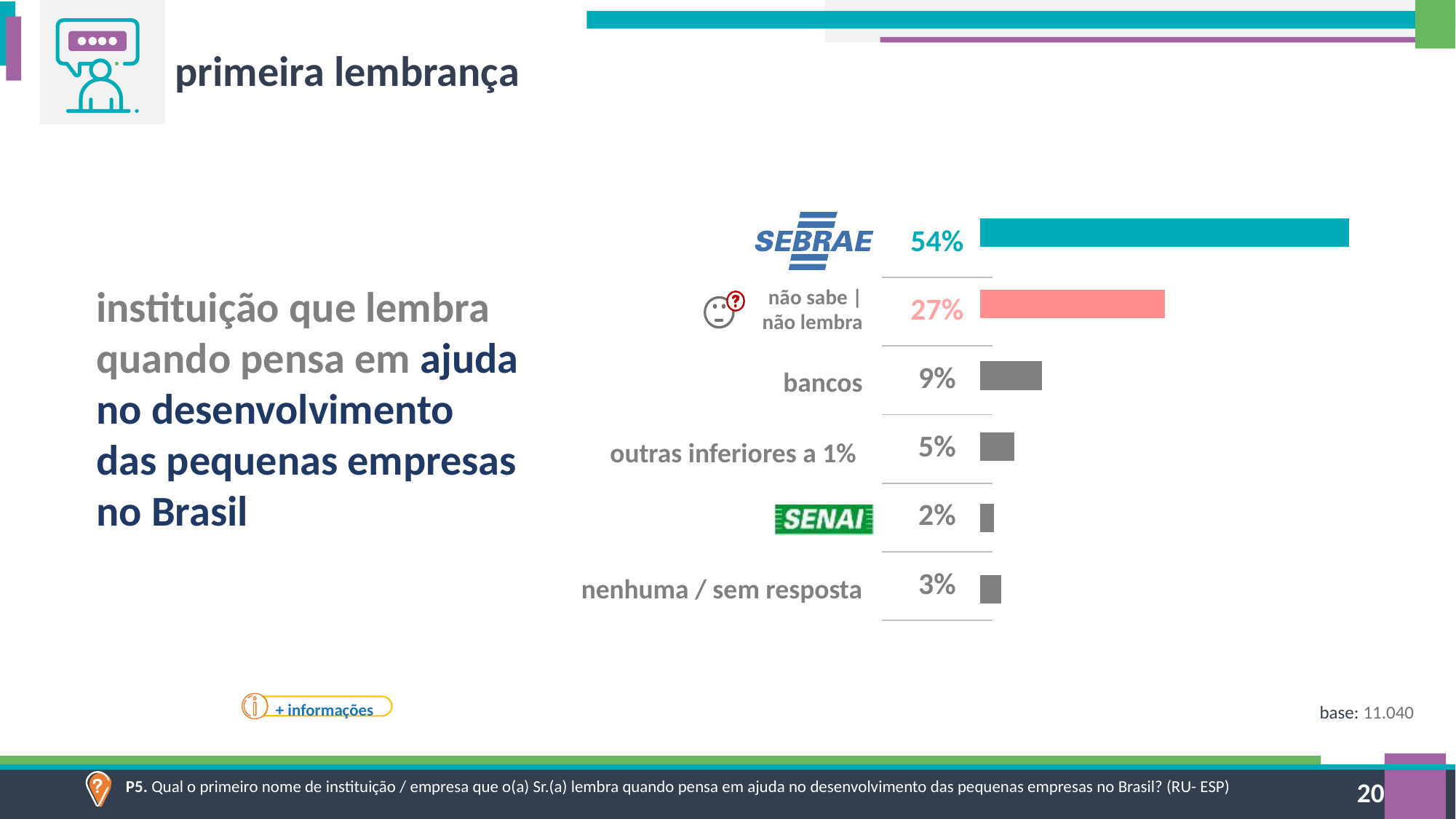
What kind of chart is shown on the slide? bar chart What is the value for 'nenhuma / sem resposta'? 3% What is the value for SENAI? 2% What percentage of respondents named SEBRAE as the first institution they remember? 54% Which is larger, the value for 'bancos' or the value for 'outras inferiores a 1%'? bancos What is the value for 'bancos'? 9% Which category has the highest value? SEBRAE What is the value for 'não sabe | não lembra'? 27% How many categories are shown in the chart? 6 Which category has the lowest value? SENAI What is the base (number of respondents) shown on the slide? 11.040 What is the difference between the SEBRAE value and the 'não sabe | não lembra' value? 27%